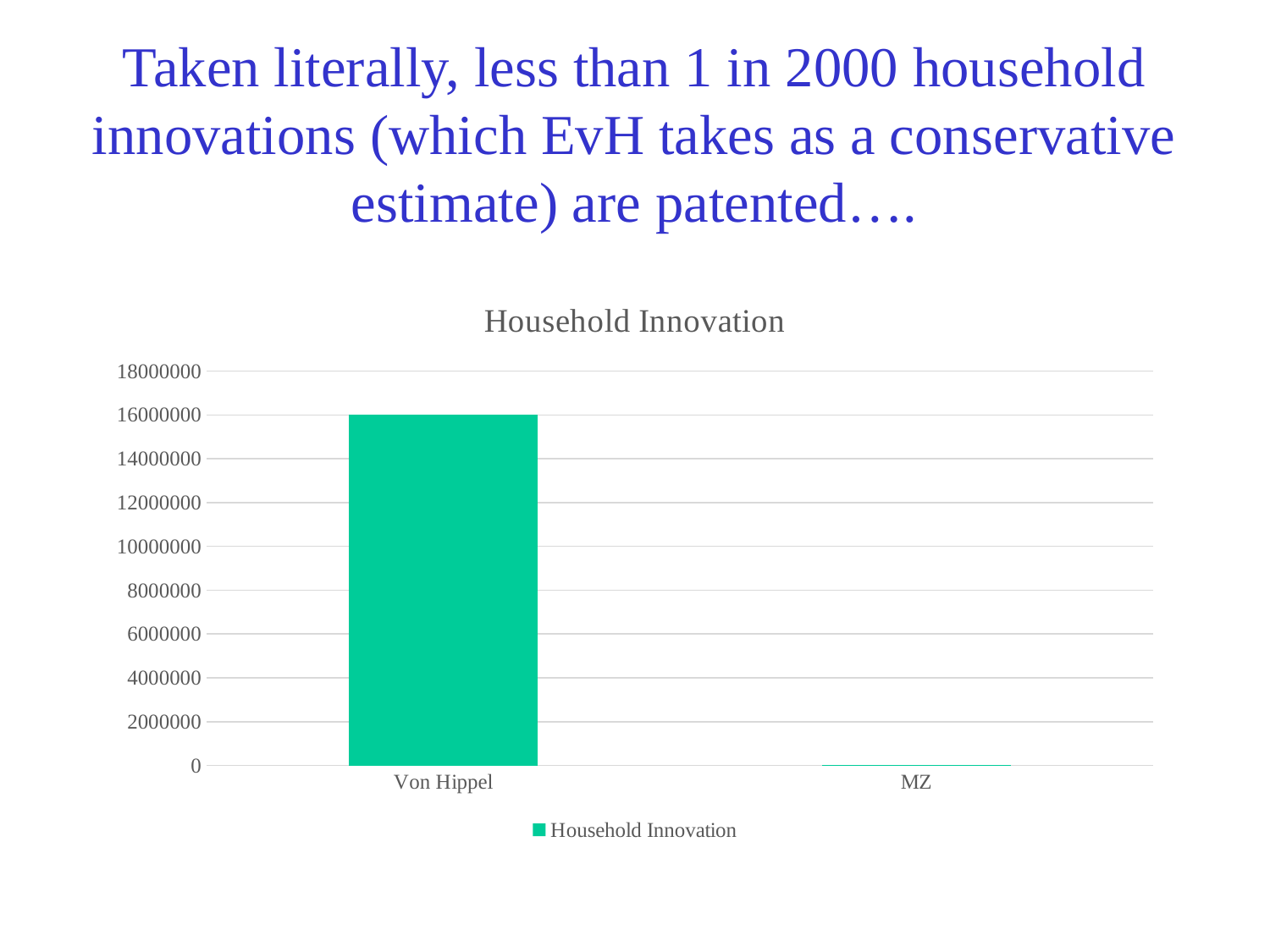
Which is larger, the value for Von Hippel or the value for MZ? Von Hippel What is the value for Von Hippel? 16000000 How many categories are shown on the x axis of the chart? 2 Is the value for Von Hippel greater or less than 10000000? greater Which category has the highest value? Von Hippel What is the title of the chart? Household Innovation Which category has the lowest value? MZ Is the value for MZ greater or less than 2000000? less What series name appears in the legend? Household Innovation Do the values rise or fall from Von Hippel to MZ along the x axis? fall How many series does the legend list? 1 What type of chart is shown on the slide? bar chart